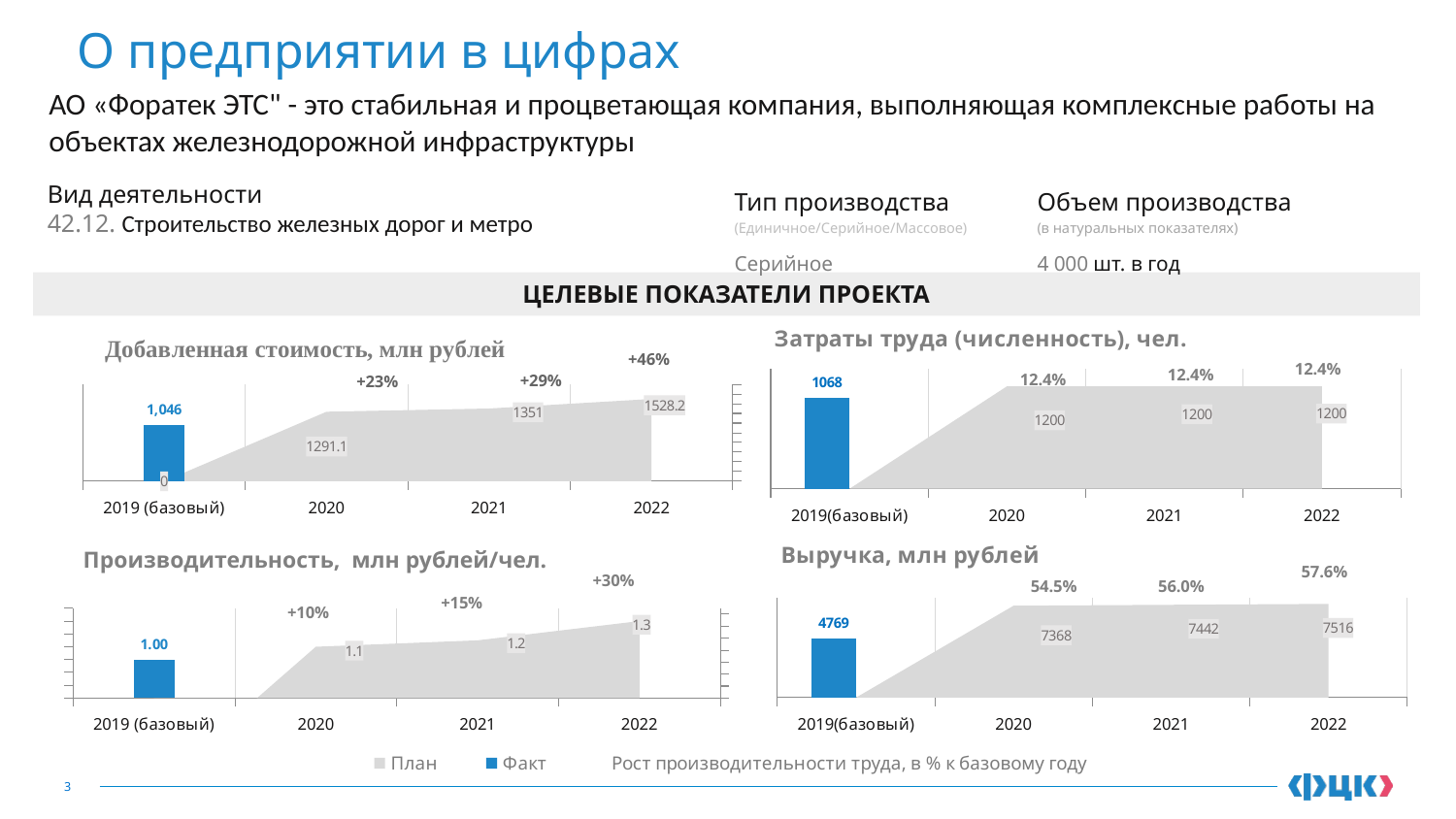
In the chart 'Добавленная стоимость, млн рублей', what percentage growth is shown above 2021? +29% In the chart 'Добавленная стоимость, млн рублей', what is the value for 2019 (базовый)? 1,046 In the chart 'Выручка, млн рублей', which year has the highest value? 2022 In the chart 'Производительность, млн рублей/чел.', what is the value for 2022? 1.3 In the chart 'Добавленная стоимость, млн рублей', do the values rise or fall from 2019 to 2022? rise In the chart 'Выручка, млн рублей', what is the difference between the 2022 value and the 2019(базовый) value? 2747 In the chart 'Затраты труда (численность), чел.', what is the value for 2021? 1200 In the chart 'Затраты труда (численность), чел.', what is the value for 2019(базовый)? 1068 In the chart 'Добавленная стоимость, млн рублей', what is the value for 2022? 1528.2 In the chart 'Производительность, млн рублей/чел.', which year has the lowest value? 2019 (базовый) In the chart 'Выручка, млн рублей', what is the value for 2019(базовый)? 4769